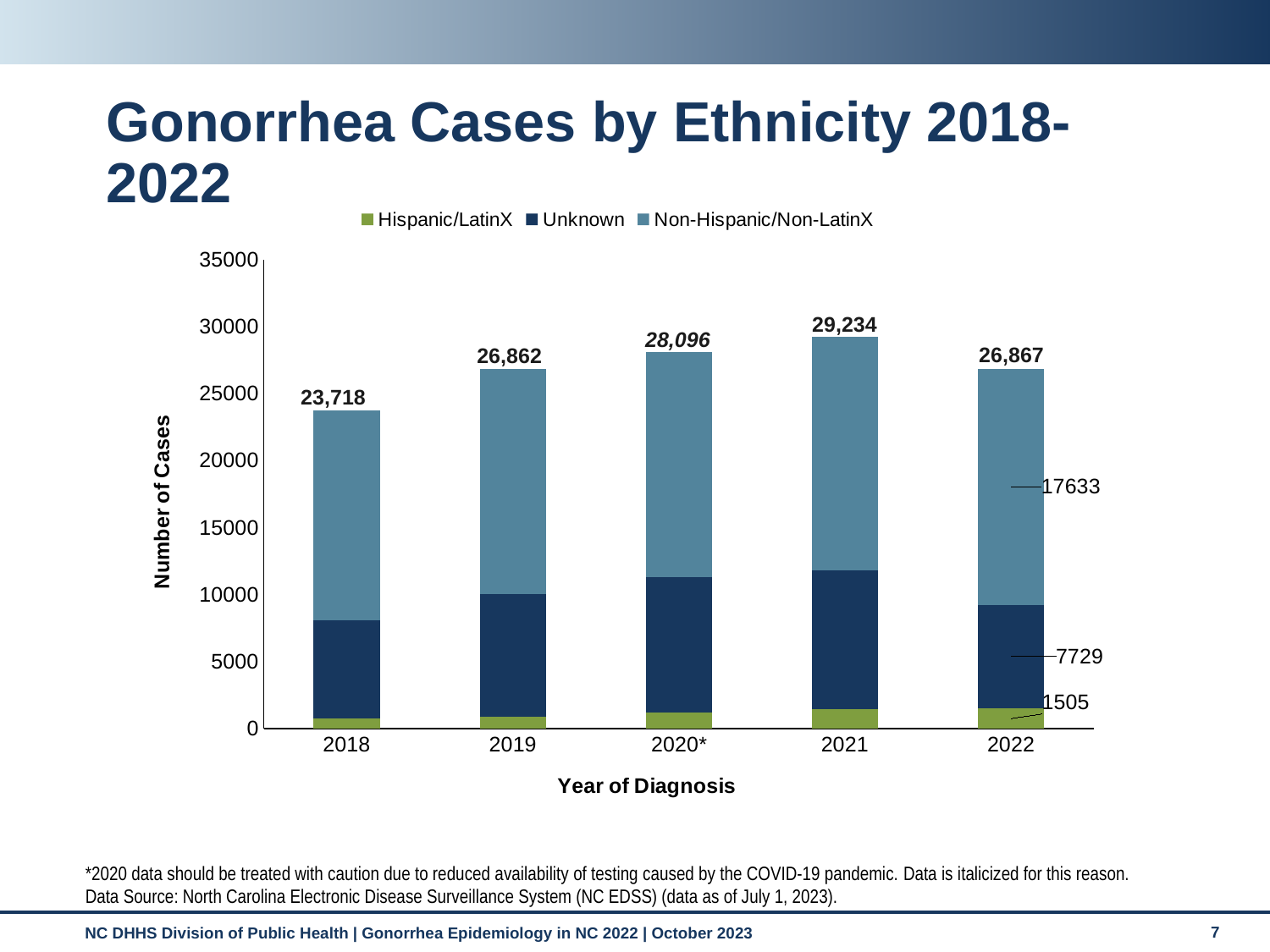
Is the Unknown value for 2018 greater or less than 5000? greater What is the Unknown value labeled for 2022? 7729 What kind of chart is shown on the slide? Stacked bar chart What is the Non-Hispanic/Non-LatinX value labeled for 2022? 17633 What is the total number of gonorrhea cases shown for 2021? 29,234 Which year has the lowest total number of cases? 2018 What is the total number of cases shown for 2018? 23,718 What is the Hispanic/LatinX value labeled for 2022? 1505 What is the difference between the total cases in 2021 and 2018? 5,516 How many series does the legend list? 3 Which year has the highest total number of cases? 2021 Which year has a larger total, 2020* or 2018? 2020*